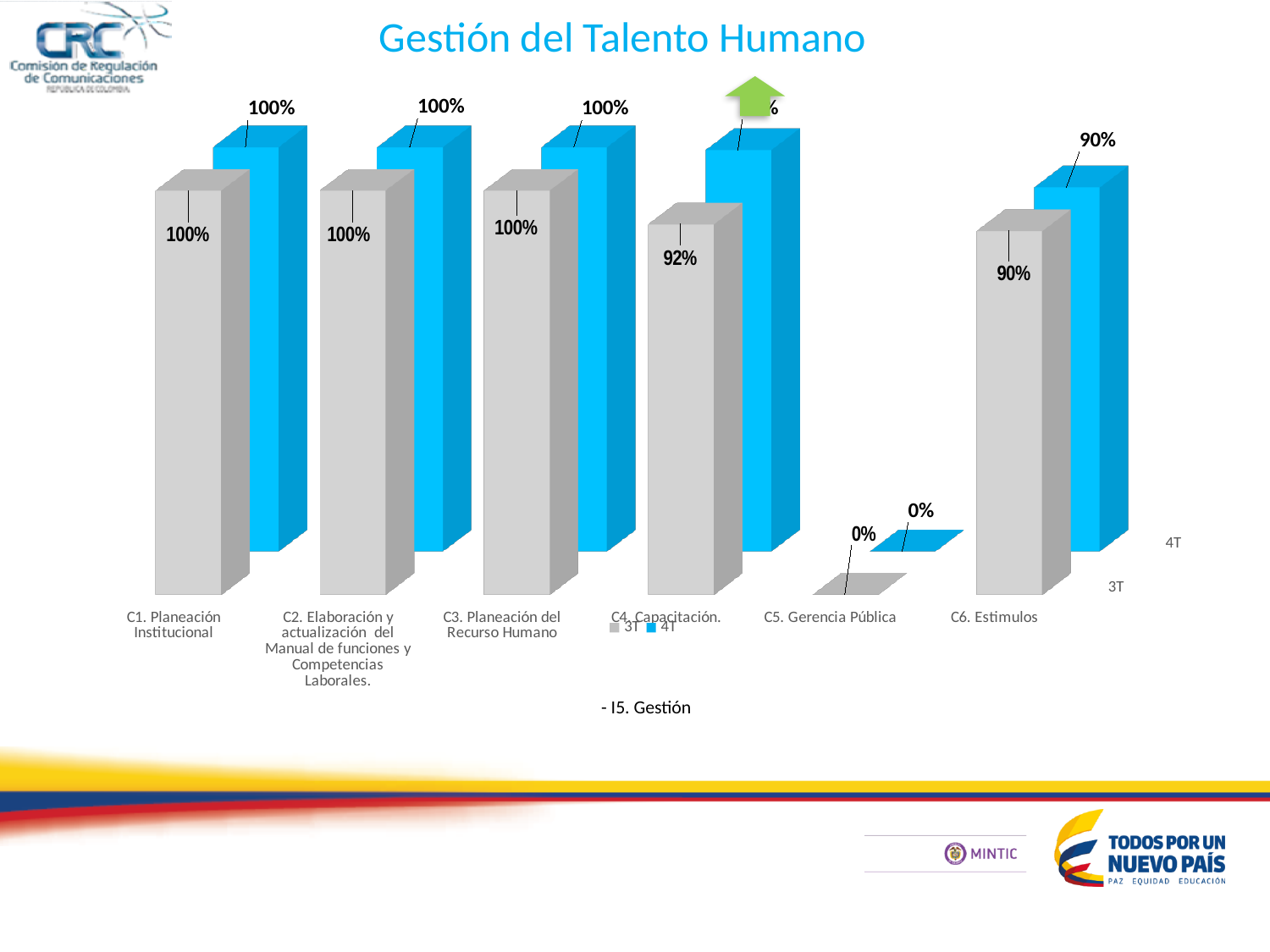
What kind of chart is shown on the slide? Bar chart Which category has the lowest 3T value? C5. Gerencia Pública What is the 3T value for C4. Capacitación? 92% How many categories are shown on the x axis of the chart? 6 What is the 4T value for C6. Estimulos? 90% How many series does the legend list? 2 What is the 3T value for C1. Planeación Institucional? 100% What is the 4T value for C5. Gerencia Pública? 0% What is the 3T value for C6. Estimulos? 90% What is the difference between the 3T value for C4. Capacitación and the 3T value for C6. Estimulos? 2% What is the difference between the 3T value for C1. Planeación Institucional and the 3T value for C4. Capacitación? 8% Which is larger: the 3T value for C4. Capacitación or the 3T value for C6. Estimulos? C4. Capacitación